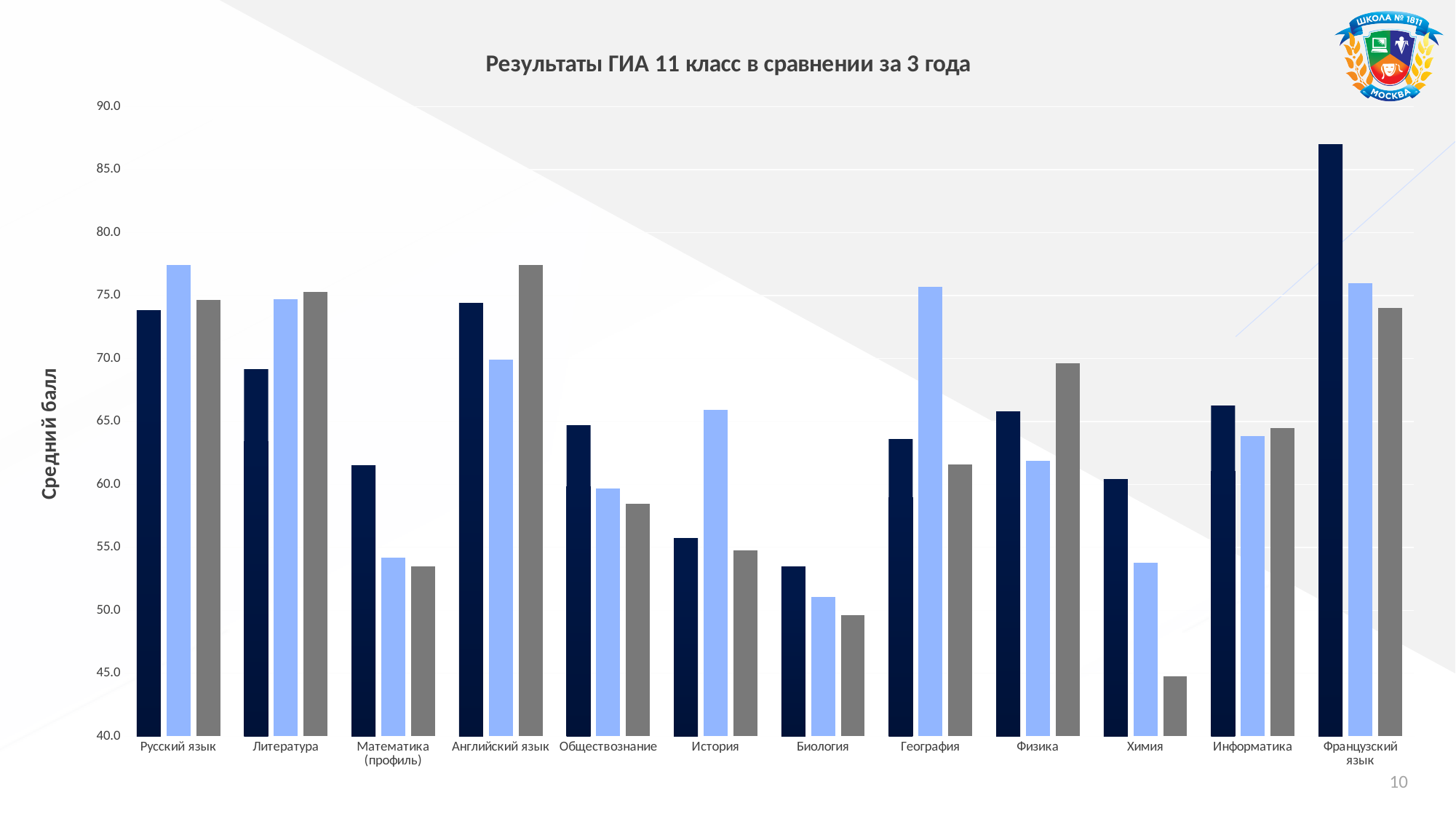
For Русский язык, which is larger: the dark navy bar or the light blue bar? the light blue bar Is the dark navy bar for Французский язык greater or less than 85.0? greater What is the label on the vertical axis of the chart? Средний балл For Физика, which is larger: the light blue bar or the grey bar? the grey bar Is the grey bar for Английский язык greater or less than 75.0? greater Which subject has the tallest bar in the chart? Французский язык What kind of chart is shown on the slide? bar chart What is the title of the chart? Результаты ГИА 11 класс в сравнении за 3 года Is the dark navy bar for Биология greater or less than 55.0? less How many subject categories are shown along the x axis? 12 Which subject has the shortest bar in the chart? Химия